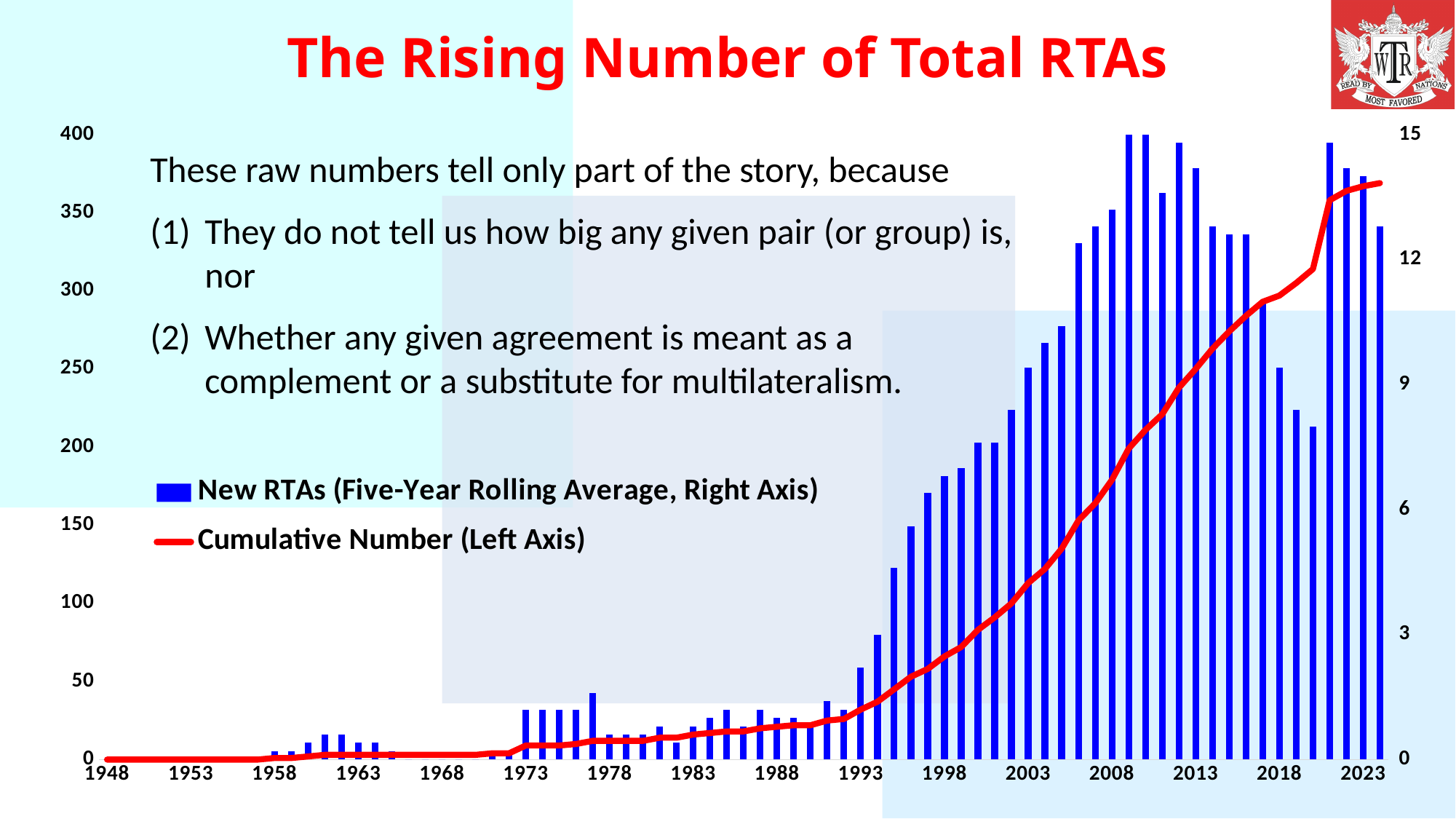
Is the New RTAs bar for 2013 greater or less than 12? greater Is the New RTAs bar for 1993 greater or less than 3? less Does the Cumulative Number line rise or fall from 1948 to 2023? Rises What kind of chart is shown on the slide? Combined bar and line chart Which is larger, the New RTAs bar for 2013 or the bar for 1973? 2013 How many series does the chart legend list? 2 What is the title of the chart? The Rising Number of Total RTAs Is the Cumulative Number in 1993 greater or less than 50? less Which axis is used for the Cumulative Number series? Left axis How many year labels are shown on the x axis? 16